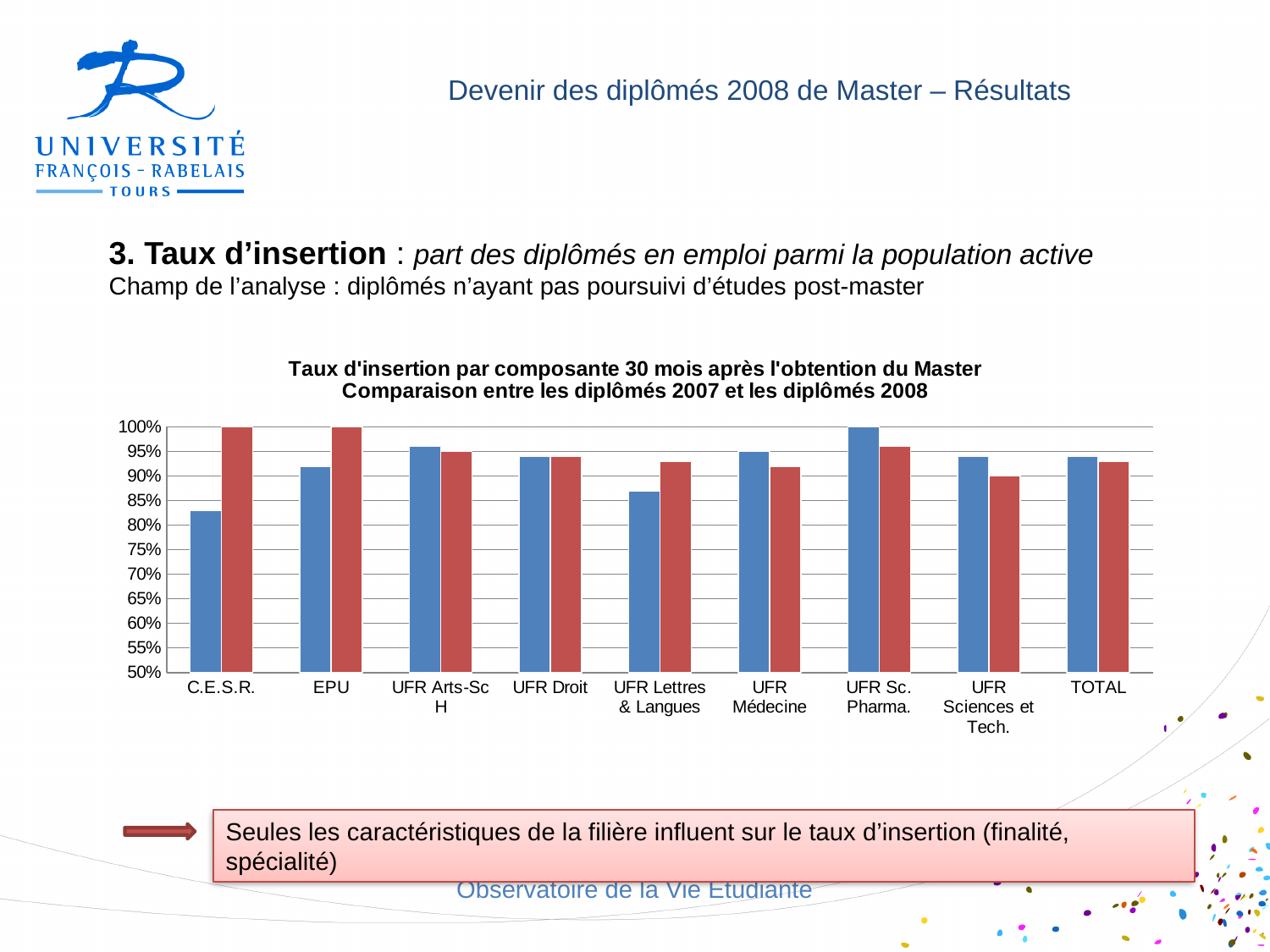
How many categories are shown along the x axis of the chart? 9 Is the value of the red bar for UFR Sciences et Tech. greater or less than 95%? less Is the value of the blue bar for C.E.S.R. greater or less than 85%? less What is the value of the blue bar for UFR Sc. Pharma.? 100% What is the value of the red bar for C.E.S.R.? 100% For C.E.S.R., which bar is larger, the blue one or the red one? the red one What is the value of the red bar for EPU? 100% Which category has the lowest blue bar? C.E.S.R. Is the value of the blue bar for UFR Lettres & Langues greater or less than 90%? less What kind of chart is shown on the slide? bar chart What is the title of the chart? Taux d'insertion par composante 30 mois après l'obtention du Master Comparaison entre les diplômés 2007 et les diplômés 2008 Which category has the highest blue bar? UFR Sc. Pharma.